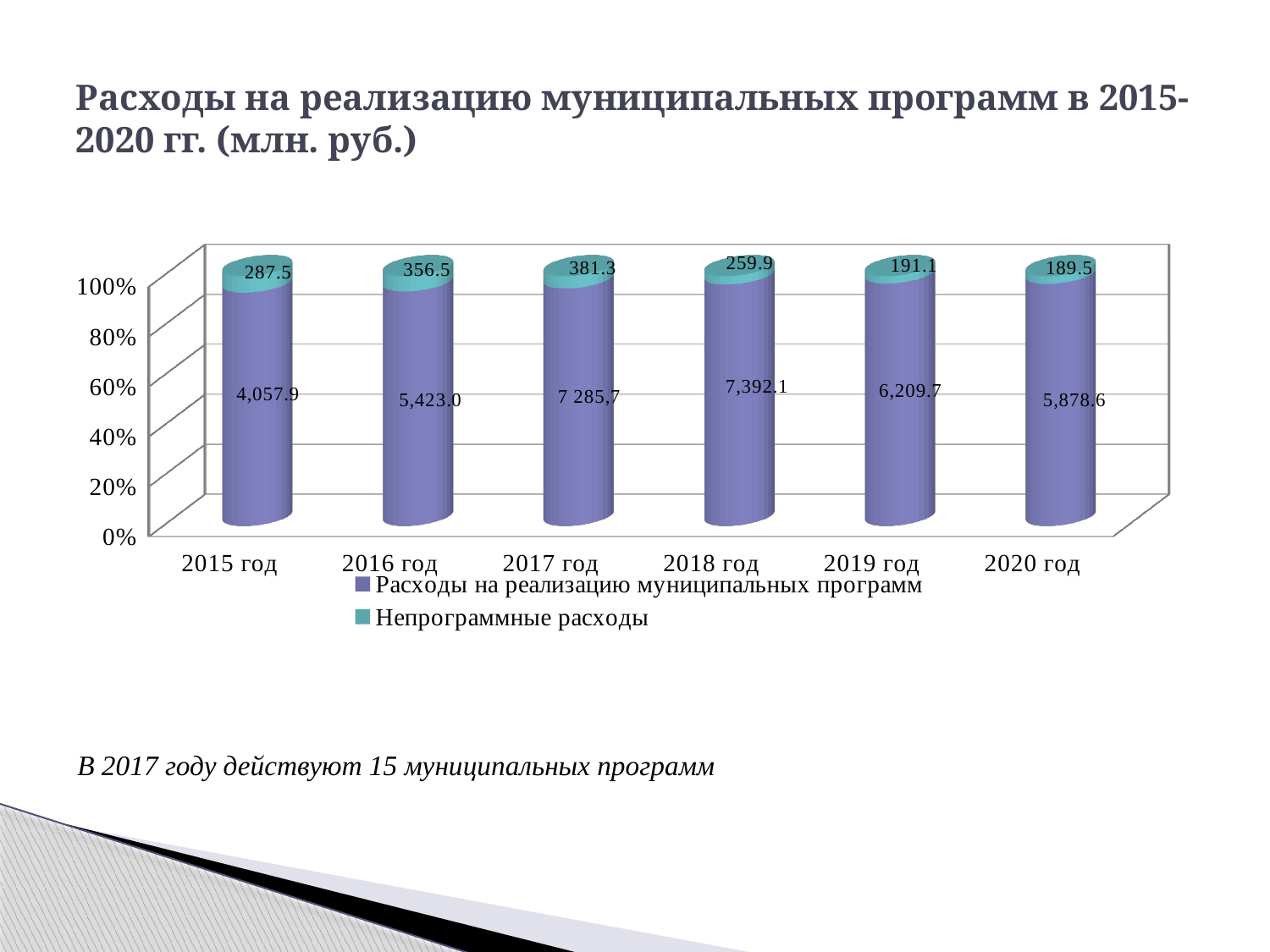
What is the value of 'Непрограммные расходы' for 2017 год? 381.3 Which is larger: 'Расходы на реализацию муниципальных программ' in 2019 год or in 2020 год? 2019 год Which year has the highest value for 'Непрограммные расходы'? 2017 год How many years are shown on the x axis? 6 Which year has the highest value for 'Расходы на реализацию муниципальных программ'? 2018 год What kind of chart is shown on the slide? Stacked bar chart How many series does the legend list? 2 What is the total of the two series for 2015 год? 4,345.4 What is the value of 'Расходы на реализацию муниципальных программ' for 2015 год? 4,057.9 What is the value of 'Расходы на реализацию муниципальных программ' for 2020 год? 5,878.6 Which year has the lowest value for 'Расходы на реализацию муниципальных программ'? 2015 год What is the difference between 'Непрограммные расходы' in 2017 год and 2018 год? 121.4